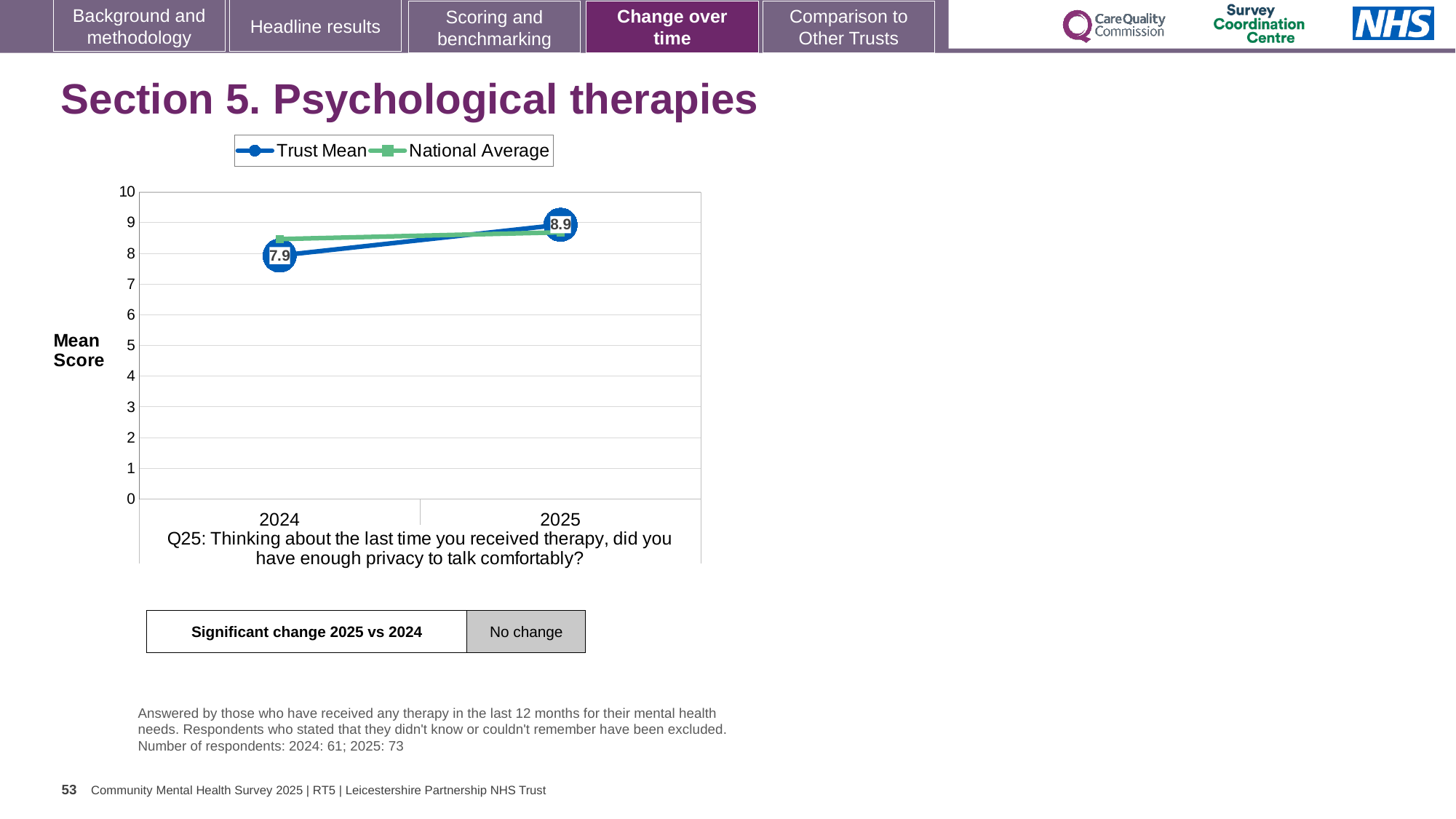
In 2024, which is larger: the Trust Mean or the National Average? National Average Is the National Average value for 2024 greater or less than 8? greater Does the Trust Mean rise or fall from 2024 to 2025? rise What is the label on the y axis of the chart? Mean Score What is the Trust Mean score for 2024? 7.9 By how much did the Trust Mean score change from 2024 to 2025? 1.0 In which year is the Trust Mean score highest? 2025 What kind of chart is shown on the slide? line chart What is the Trust Mean score for 2025? 8.9 How many years are plotted on the x axis? 2 How many series does the legend list? 2 In which year is the Trust Mean score lowest? 2024